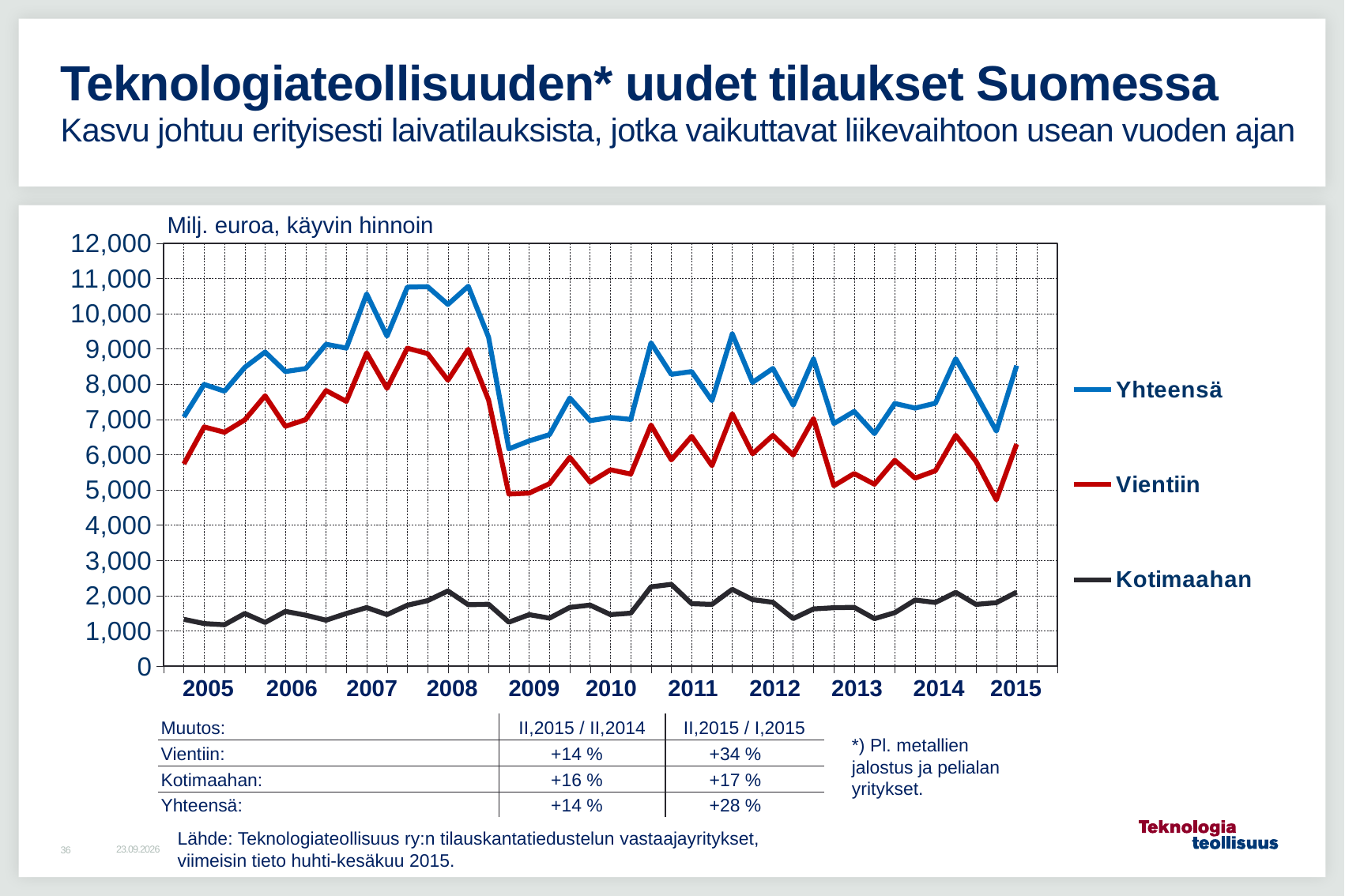
Which series has the lowest values throughout the chart? Kotimaahan Does the Yhteensä series rise or fall from 2008 to 2009? fall Is the value for Kotimaahan in 2015 greater or less than 3,000? less Which series are listed in the chart legend? Yhteensä, Vientiin, Kotimaahan Is the value for Vientiin at the start of 2009 greater or less than 6,000? less Which is larger in 2015, the value for Vientiin or the value for Kotimaahan? Vientiin What kind of chart is shown on the slide? line chart How many series does the chart legend list? 3 Is the peak value for Yhteensä in 2008 greater or less than 10,000? greater What unit label is shown above the y axis of the chart? Milj. euroa, käyvin hinnoin How many years are labelled on the x axis of the chart? 11 Which series has the highest values throughout the chart? Yhteensä